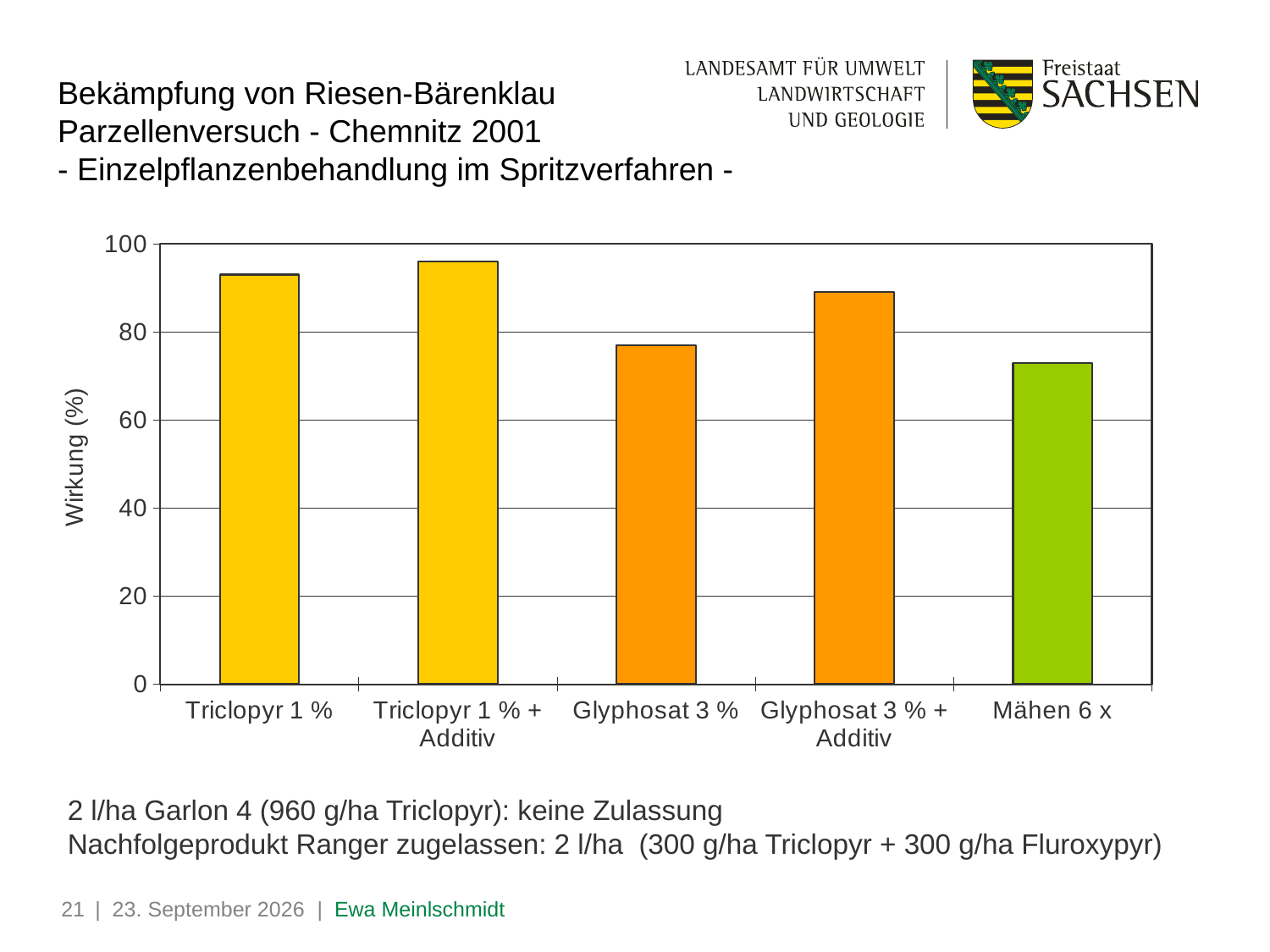
Is the value for Triclopyr 1 % greater or less than 80? greater Is the value for Glyphosat 3 % + Additiv greater or less than 80? greater Which category has the lowest Wirkung (%) in the chart? Mähen 6 x How many categories are shown on the x axis of the chart? 5 Which category has the highest Wirkung (%) in the chart? Triclopyr 1 % + Additiv Is the value for Glyphosat 3 % greater or less than 80? less Which has the larger Wirkung (%): Glyphosat 3 % or Glyphosat 3 % + Additiv? Glyphosat 3 % + Additiv What colour is the bar for Mähen 6 x? green Which has the larger Wirkung (%): Triclopyr 1 % or Glyphosat 3 %? Triclopyr 1 % What kind of chart is shown on the slide? bar chart What is the label of the y axis of the chart? Wirkung (%)